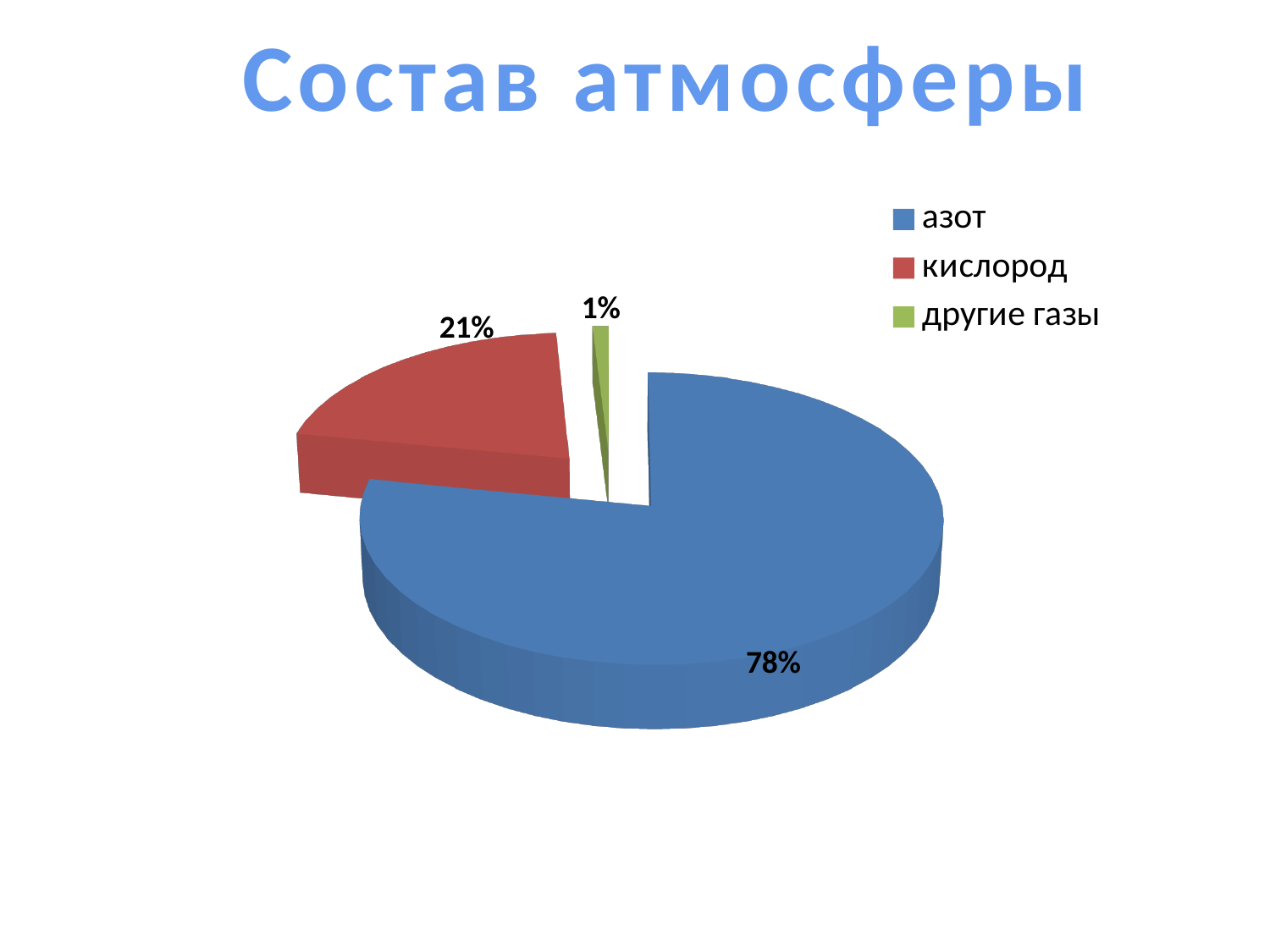
What percentage is labelled for другие газы? 1% What percentage does the кислород slice show? 21% What type of chart is shown on the slide? pie chart Which category has the largest slice of the pie? азот What is the difference in percentage points between азот and кислород? 57 How many slices does the pie chart have? 3 Which is larger, the share for кислород or the share for другие газы? кислород What percentage of the atmosphere is азот according to the pie chart? 78% Which category has the smallest slice of the pie? другие газы What colour is the slice for кислород? red What is the title of the slide? Состав атмосферы How many entries does the legend list? 3